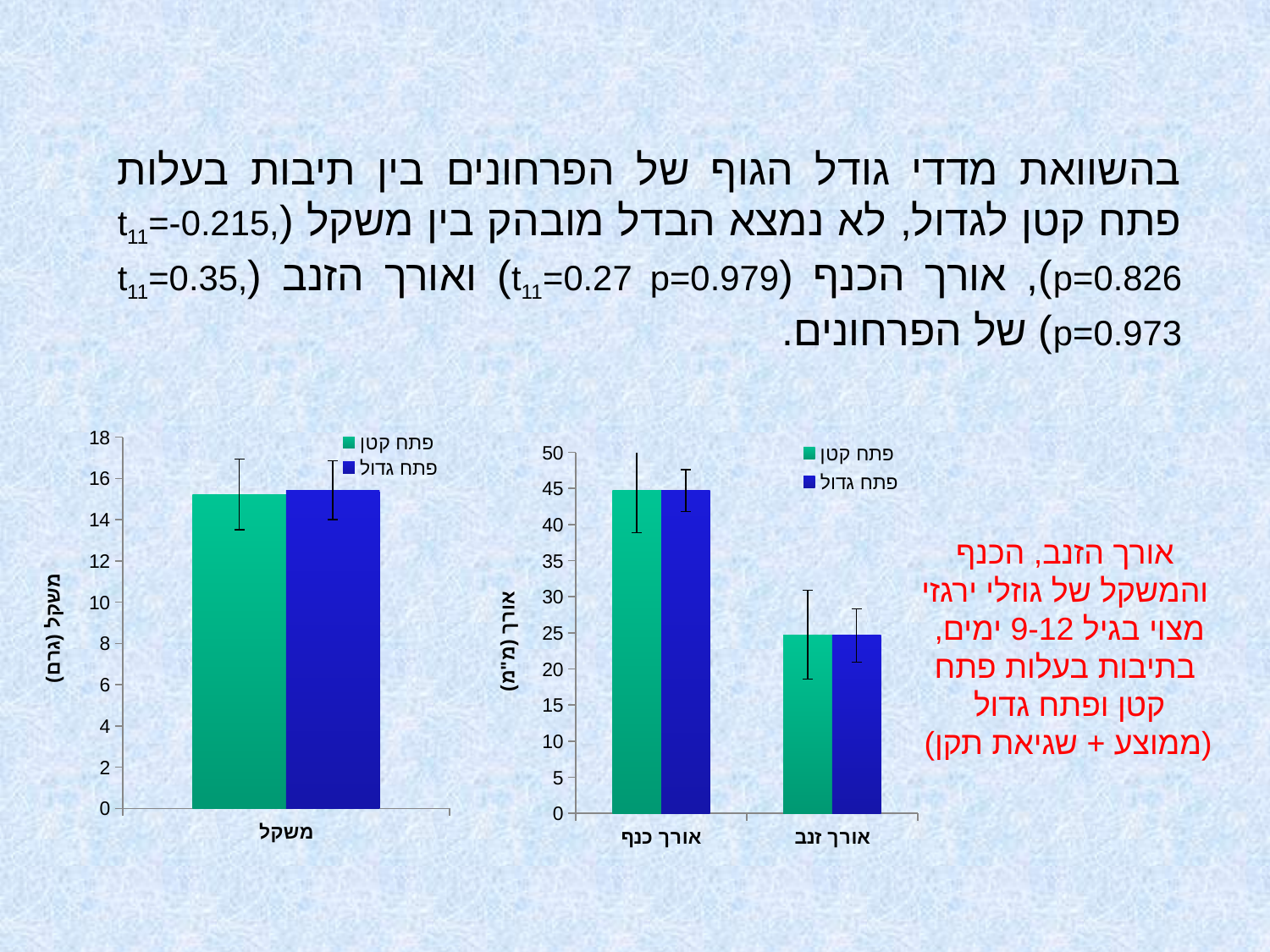
How many categories are shown on the x axis of the right chart (אורך)? 2 How many series does the legend of the right chart (אורך) list? 2 In the right chart (אורך), which category has the lowest values? אורך זנב In the left chart (משקל), is the value of פתח גדול greater or less than 16? less How many categories are shown on the x axis of the left chart (משקל)? 1 In the left chart (משקל), is the value of פתח קטן greater or less than 14? greater In the right chart (אורך), is the value of פתח גדול for אורך זנב greater or less than 30? less In the right chart (אורך), which category has the higher value for פתח קטן: אורך כנף or אורך זנב? אורך כנף What kind of chart is the right chart (אורך)? bar chart What kind of chart is the left chart (משקל)? bar chart What is the y-axis label of the left chart? משקל (גרם)